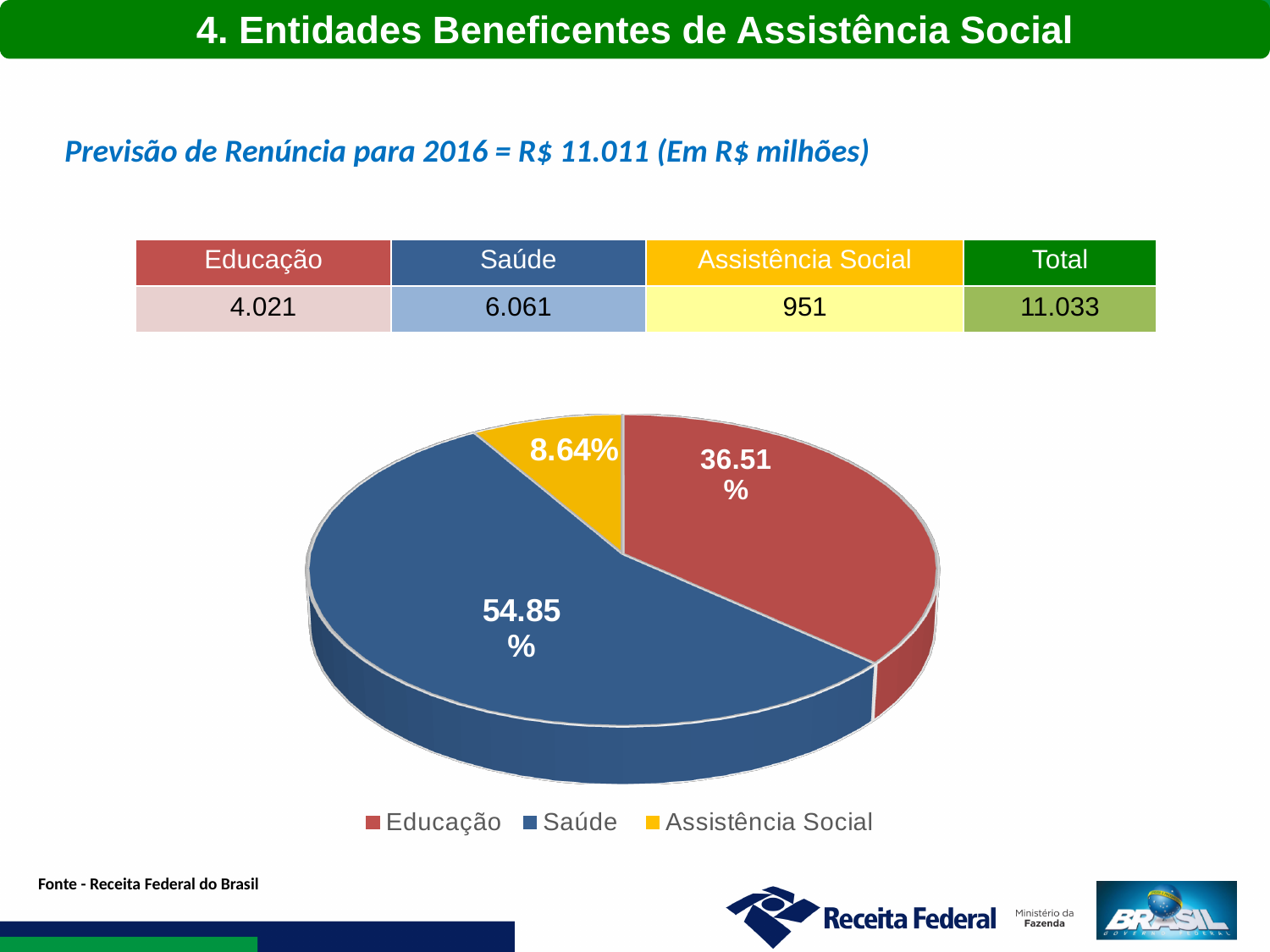
What share of the pie chart does Assistência Social represent? 8.64% What share of the pie chart does Educação represent? 36.51% What colour is the Saúde slice in the pie chart? Blue What colour is the Assistência Social slice in the pie chart? Yellow Which category has the smallest slice in the pie chart? Assistência Social What share of the pie chart does Saúde represent? 54.85% Which category has the largest slice in the pie chart? Saúde How many entries does the chart legend list? 3 How many slices does the pie chart have? 3 What type of chart is shown on the slide? Pie chart Which slice is larger in the pie chart, Educação or Saúde? Saúde What is the difference in percentage points between the Saúde and Educação slices? 18.34